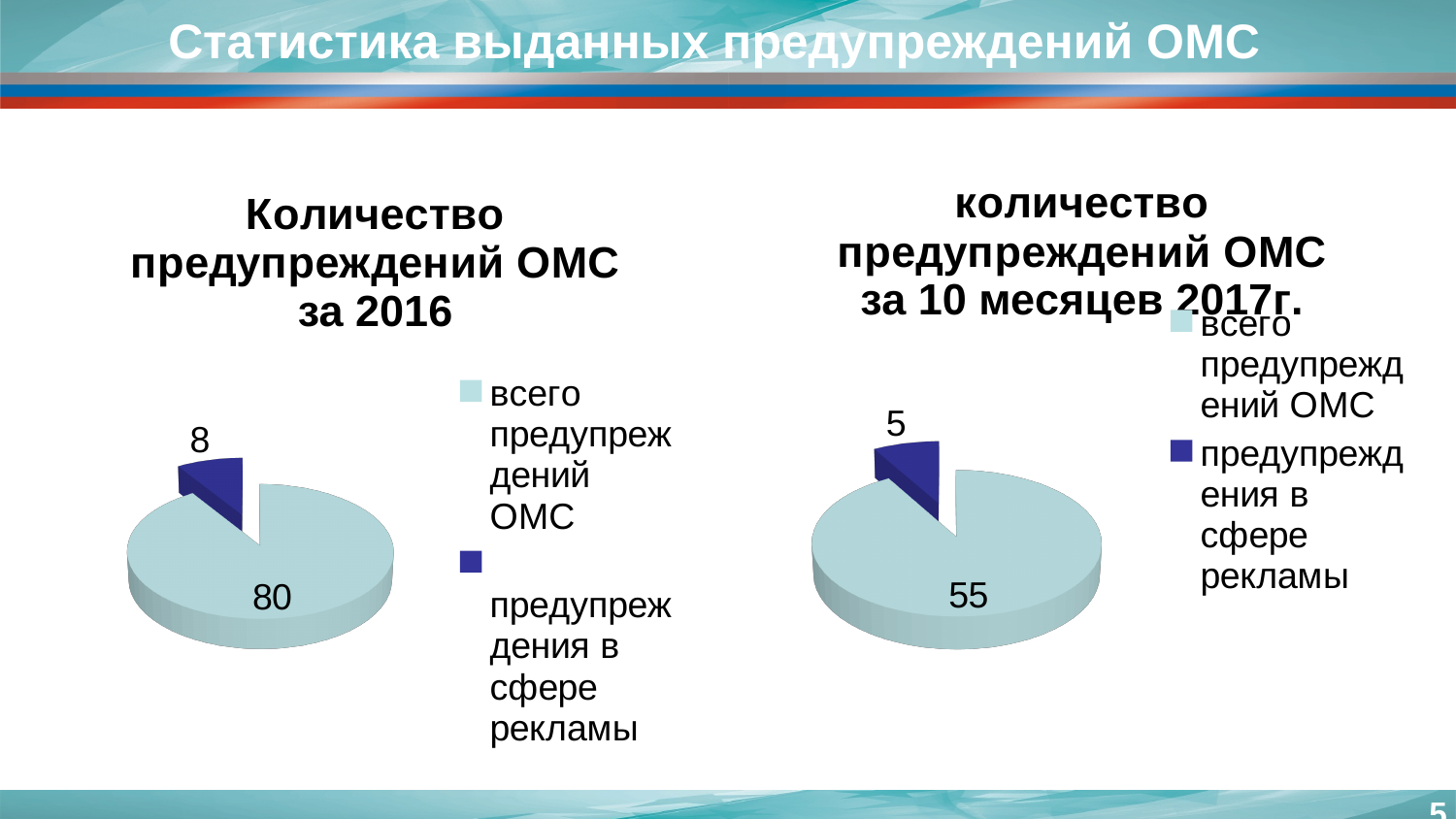
In the left chart (за 2016), what is the difference between the two plotted values? 72 In the right chart (количество предупреждений ОМС за 10 месяцев 2017г.), what is the value for предупреждения в сфере рекламы? 5 How many slices does the right chart (за 10 месяцев 2017г.) have? 2 In the right chart (за 10 месяцев 2017г.), which category has the smallest slice? предупреждения в сфере рекламы In the left chart (Количество предупреждений ОМС за 2016), what is the value for всего предупреждений ОМС? 80 In the right chart (количество предупреждений ОМС за 10 месяцев 2017г.), what is the value for всего предупреждений ОМС? 55 In the right chart (за 10 месяцев 2017г.), what is the difference between the two plotted values? 50 In the left chart (Количество предупреждений ОМС за 2016), what is the value for предупреждения в сфере рекламы? 8 What type of chart is used on the left side of the slide? Pie chart What is the title of the left chart? Количество предупреждений ОМС за 2016 In the left chart (за 2016), which category has the largest slice? всего предупреждений ОМС Which is larger: the value for всего предупреждений ОМС in the left chart (2016) or in the right chart (10 месяцев 2017г.)? Left chart (2016)